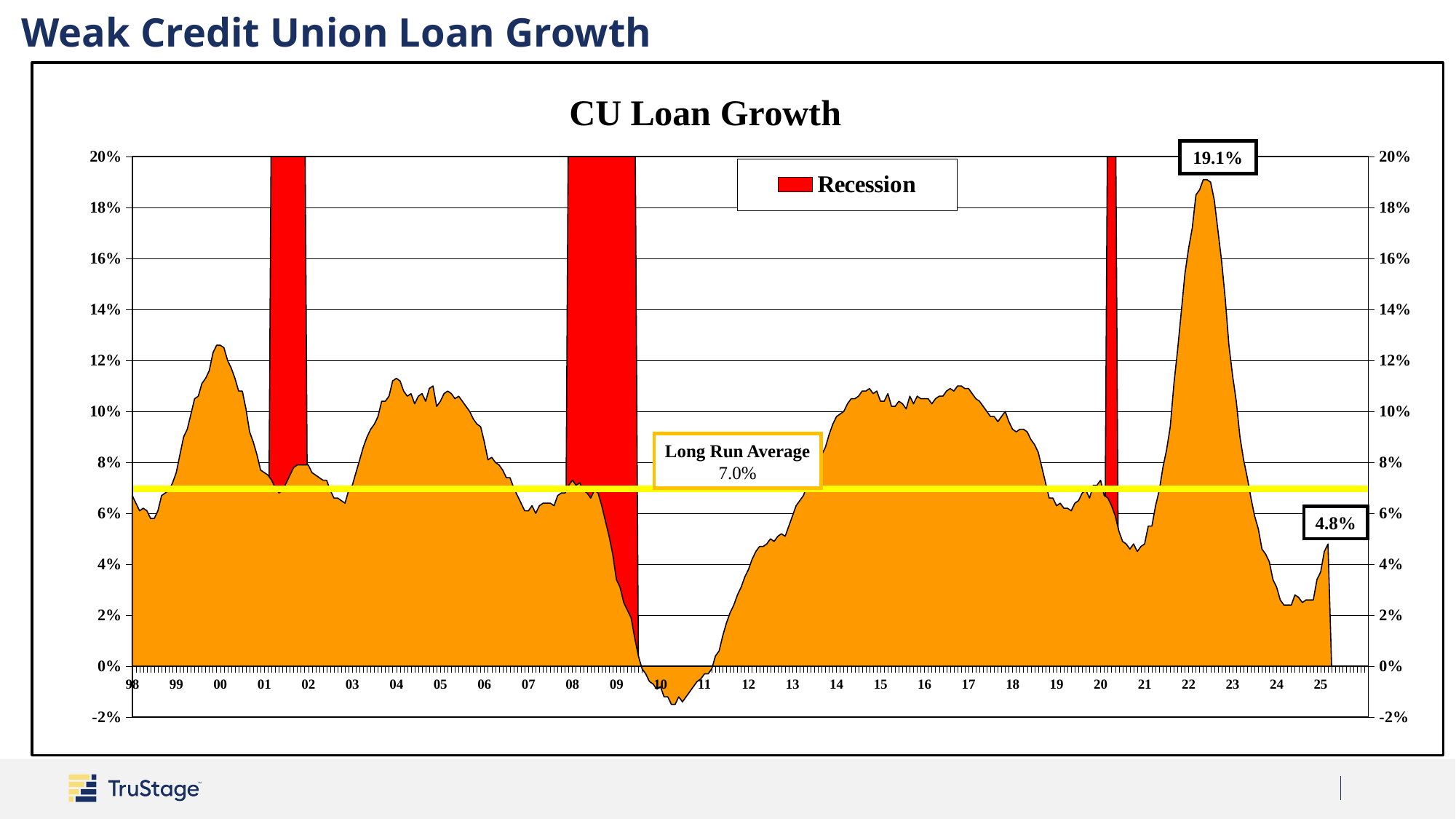
What entry does the chart's legend list? Recession Which is larger: the peak in loan growth around 2022 or the peak around 2000? the peak around 2022 What is the peak value labeled on the CU Loan Growth chart? 19.1% What is the most recent value labeled at the right end of the CU Loan Growth chart? 4.8% What is the title of the chart on the slide? CU Loan Growth Is the lowest value of loan growth around 2010 greater or less than 0%? less How many red recession bands are shown on the chart? 3 Is the peak value of loan growth around 2000 greater or less than 10%? greater What is the Long Run Average shown on the chart? 7.0% What kind of chart is shown on the slide? area chart Do loan growth values rise or fall from the 2022 peak to 2024? fall What is the difference between the labeled peak of 19.1% and the latest value of 4.8%? 14.3 percentage points